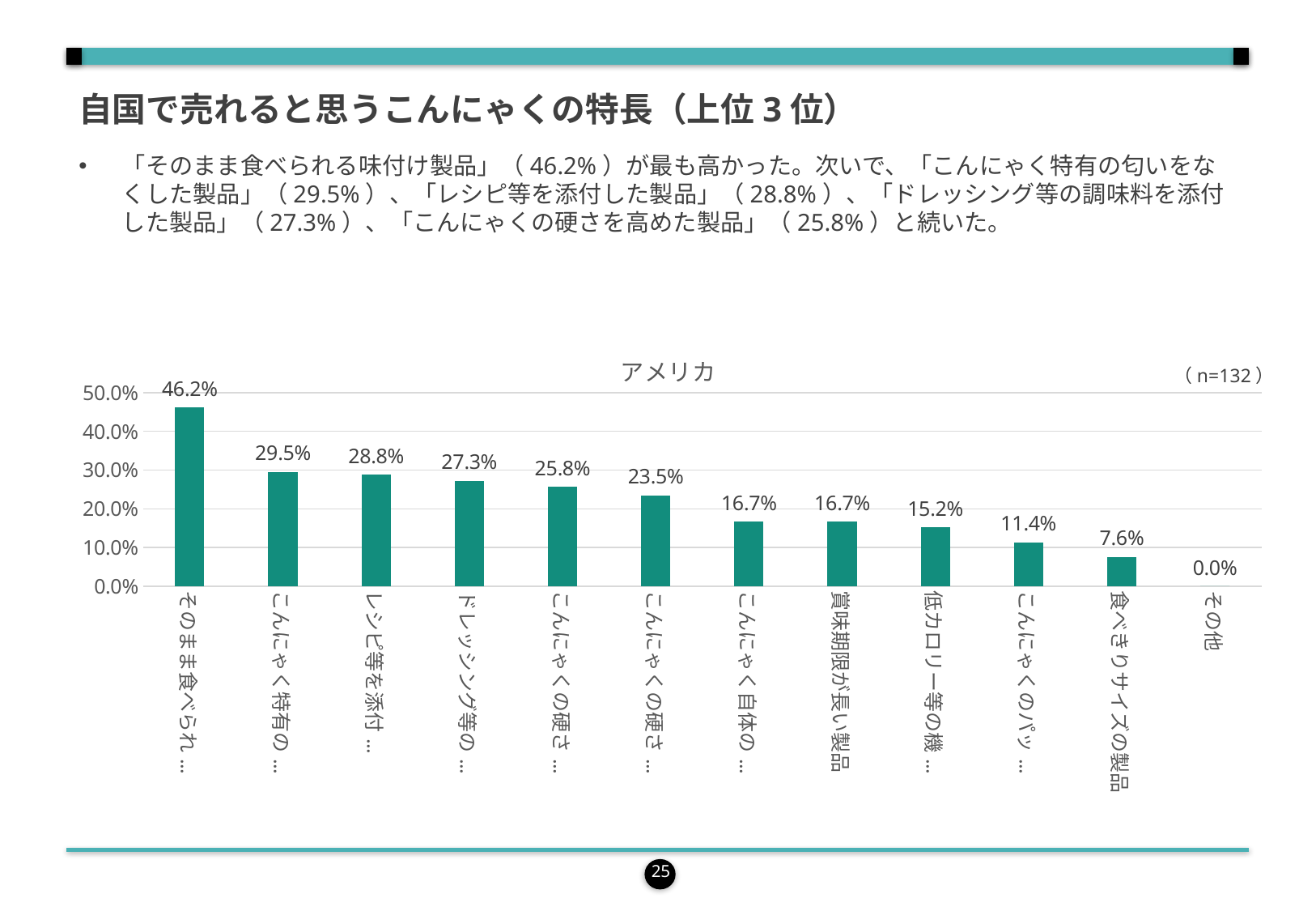
Do the bar values generally rise or fall from left to right along the x axis? fall What is the value for 賞味期限が長い製品? 16.7% What is the value of the first (leftmost) bar in the chart? 46.2% What is the value for 食べきりサイズの製品? 7.6% Which category has the lowest value in the chart? その他 What is the title of the chart? アメリカ What is the difference between the value of the first bar (46.2%) and the value for 食べきりサイズの製品? 38.6% How many categories (bars) are shown in the chart? 12 What type of chart is shown on the slide? bar chart What sample size (n) is shown for the chart? n=132 What is the value for その他? 0.0% Which is larger: the value for 賞味期限が長い製品 or the value for 食べきりサイズの製品? 賞味期限が長い製品